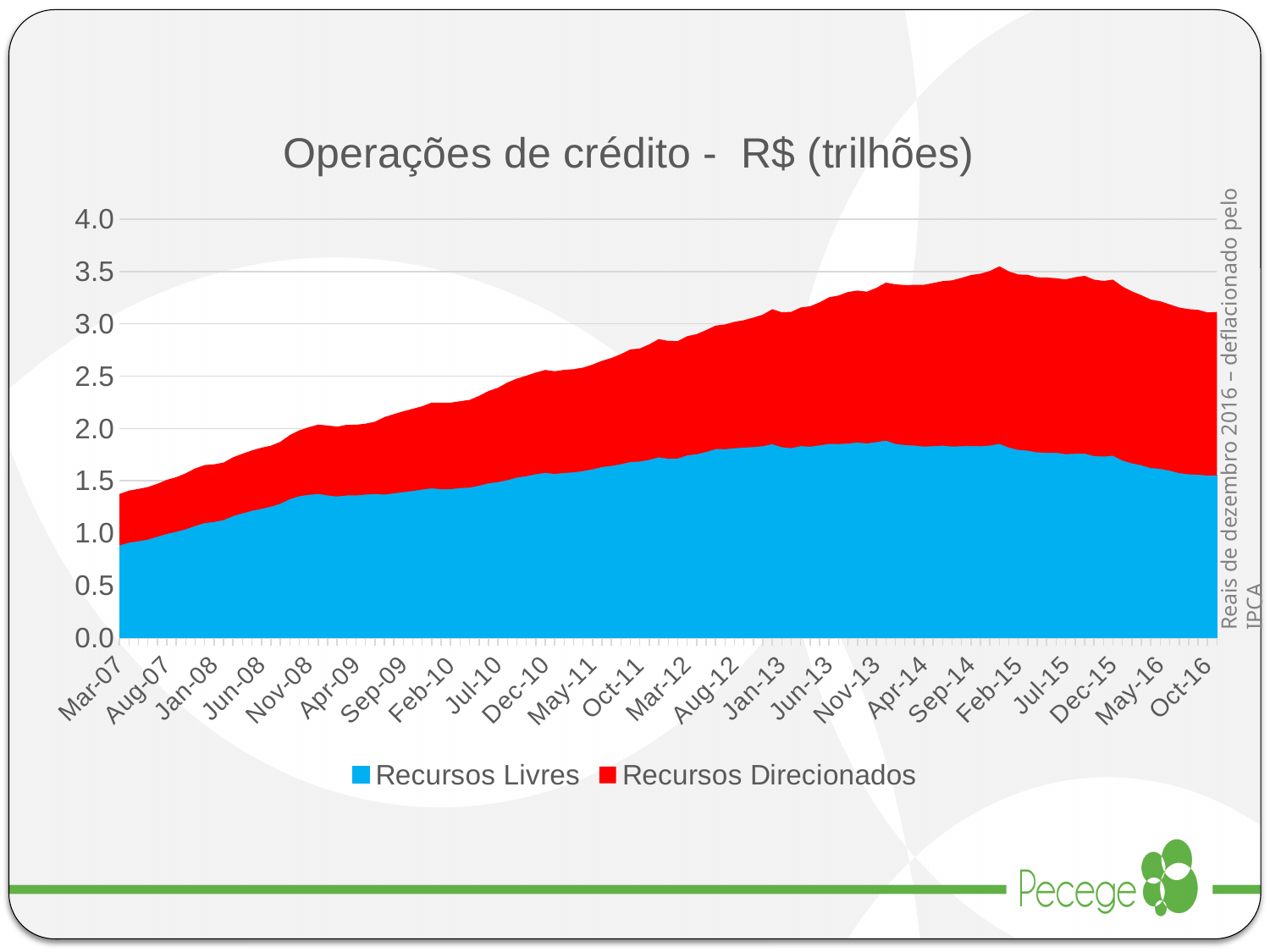
What kind of chart is shown on the slide? Stacked area chart Is the value for Recursos Livres at Mar-07 greater or less than 1.0? less Is the total of the stacked areas at Mar-07 greater or less than 1.5? less Does the total of the stacked areas rise or fall between Mar-07 and Feb-15? Rise At Mar-07, which series has the larger value, Recursos Livres or Recursos Direcionados? Recursos Livres Does the total of the stacked areas rise or fall between Feb-15 and Oct-16? Fall Which colour represents Recursos Direcionados in the chart? Red How many series does the legend list? 2 Is the total of the stacked areas at Oct-16 greater or less than 3.0? greater What is the title of the chart? Operações de crédito - R$ (trilhões)